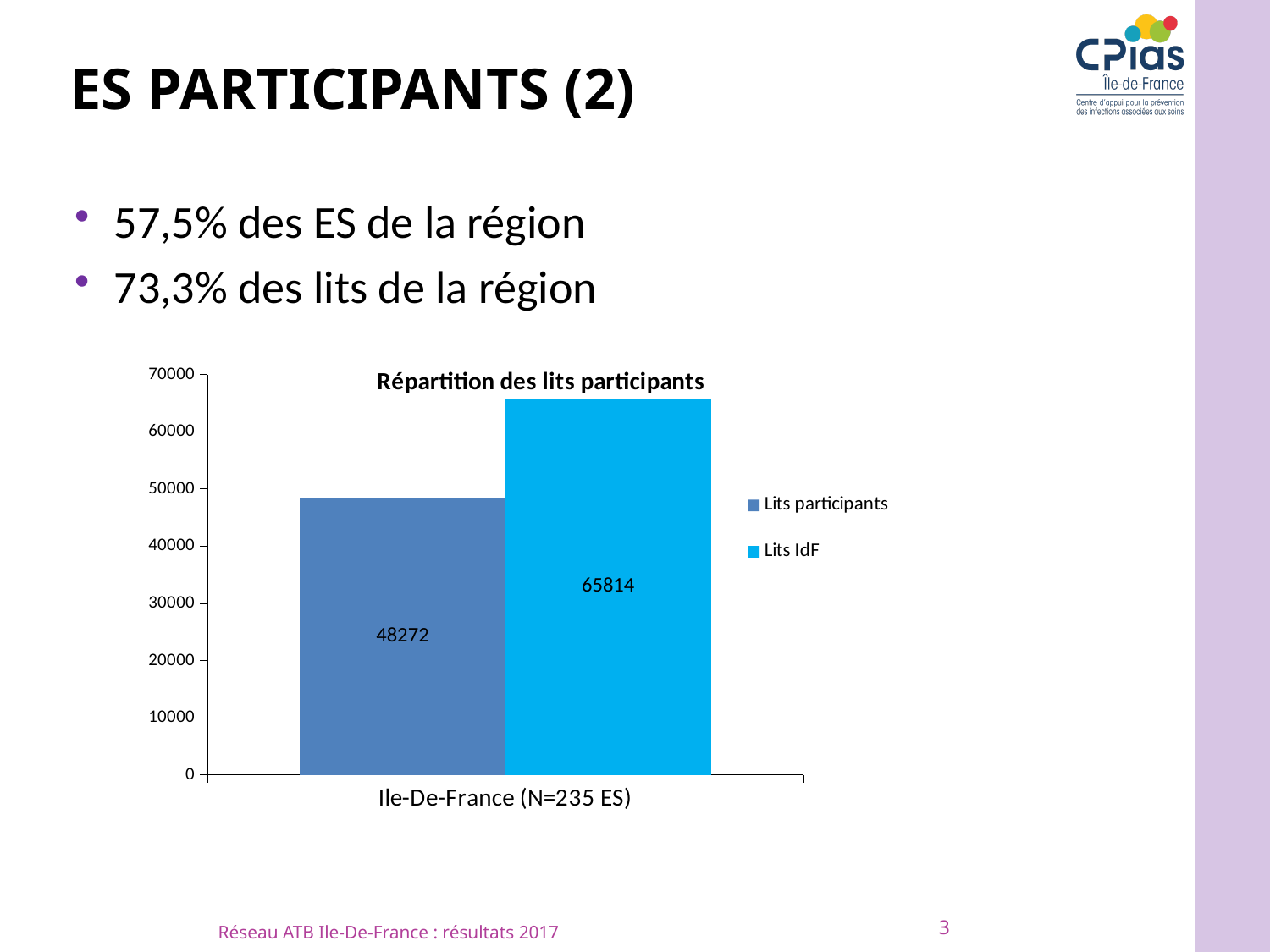
What is the difference between Lits IdF and Lits participants? 17542 Which series has the higher value, Lits participants or Lits IdF? Lits IdF How many series does the legend list? 2 What is the title of the chart? Répartition des lits participants Which series has the lowest value in the chart? Lits participants What kind of chart is shown on the slide? Bar chart Is the value for Lits IdF greater or less than 60000? greater How many categories are shown on the x axis of the chart? 1 What is the value for Lits IdF in the chart? 65814 What is the value for Lits participants in the chart? 48272 What is the category label on the x axis of the chart? Ile-De-France (N=235 ES) Is the value for Lits participants greater or less than 50000? less